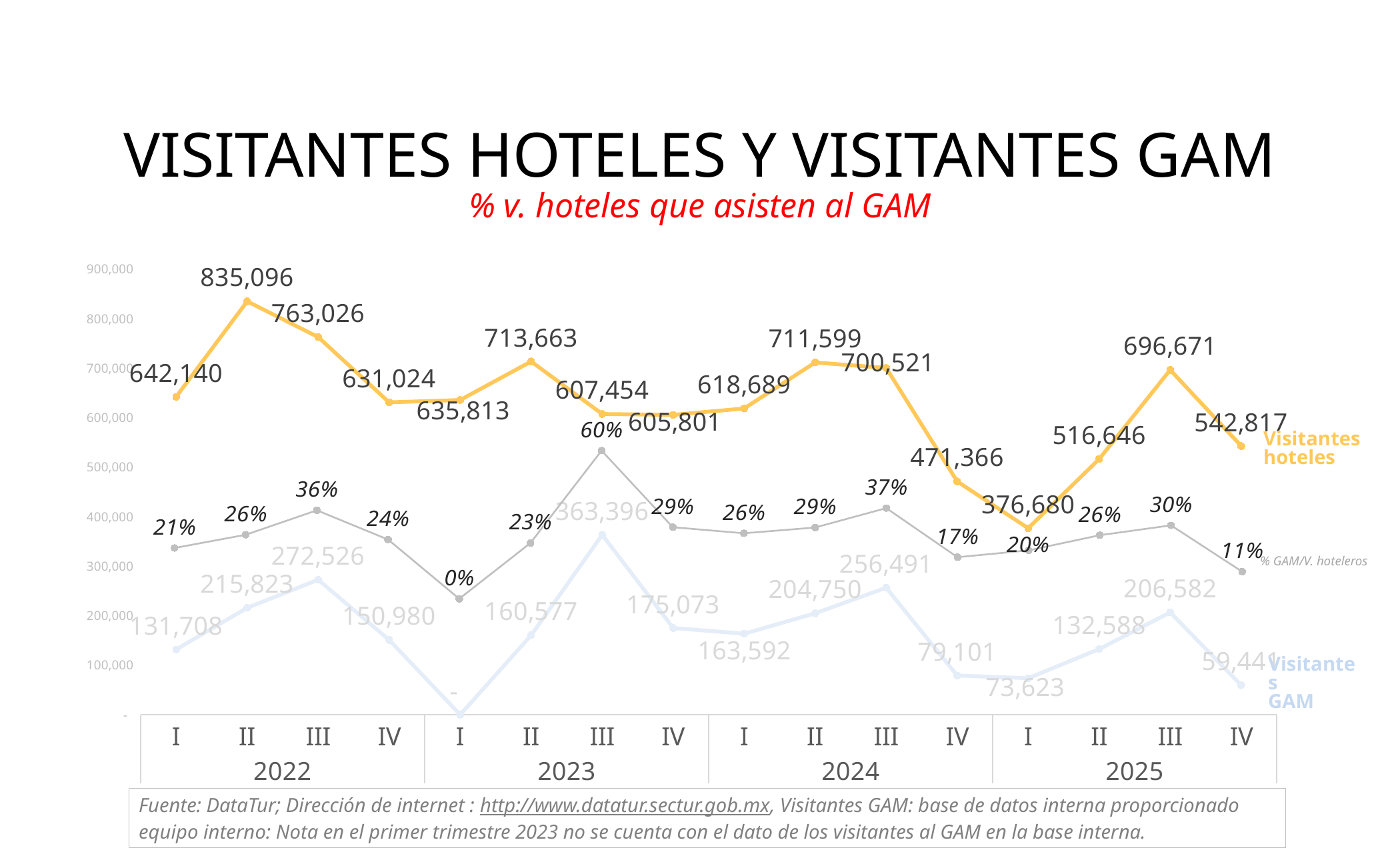
What kind of chart is shown on the slide? Line chart How many quarters are plotted along the x axis? 16 Which is larger for Visitantes hoteles: quarter II of 2023 or quarter III of 2025? II 2023 What is the value of Visitantes GAM in quarter III of 2023? 363,396 What is the value of Visitantes hoteles in quarter II of 2022? 835,096 In which quarter and year is the Visitantes hoteles series at its lowest? I 2025 What is the % GAM/V. hoteleros value in quarter III of 2023? 60% How many data series are plotted on the chart? 3 What is the value of Visitantes GAM in quarter IV of 2025? 59,441 In which quarter and year is the Visitantes hoteles series at its highest? II 2022 What is the difference between Visitantes hoteles in II 2022 and III 2022? 72,070 Does the Visitantes hoteles series rise or fall from quarter II to quarter IV of 2022? Fall